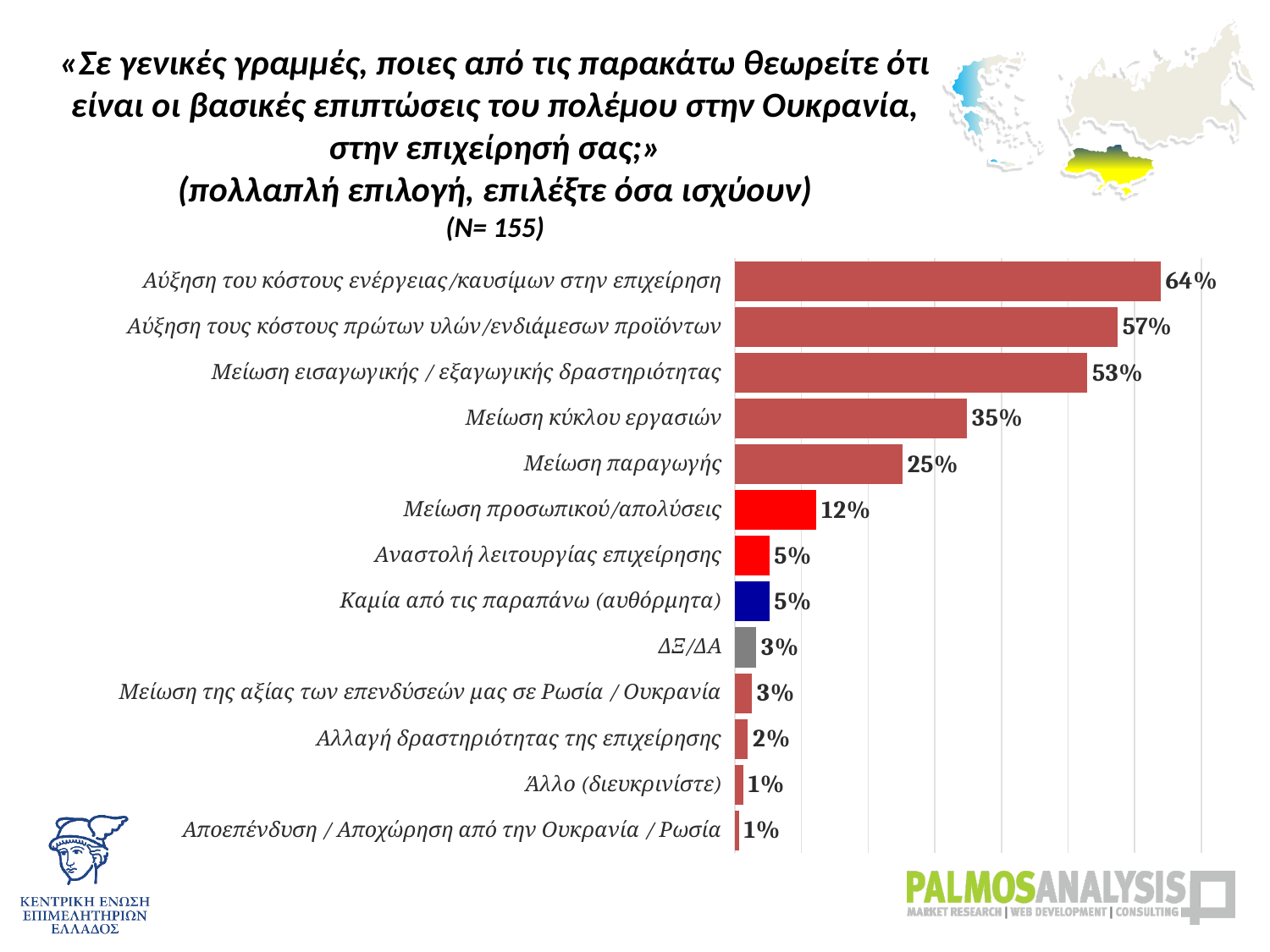
What type of chart is shown on the slide? Bar chart Which is larger: the value for «Μείωση εισαγωγικής / εξαγωγικής δραστηριότητας» or the value for «Μείωση κύκλου εργασιών»? Μείωση εισαγωγικής / εξαγωγικής δραστηριότητας What is the sample size (N) stated on the slide? 155 Which category has the highest percentage in the chart? Αύξηση του κόστους ενέργειας/καυσίμων στην επιχείρηση How many categories are shown in the chart? 13 What is the value for «ΔΞ/ΔΑ»? 3% What is the lowest percentage value shown in the chart? 1% What percentage is shown for «Μείωση προσωπικού/απολύσεις»? 12% What is the difference between «Μείωση κύκλου εργασιών» and «Μείωση παραγωγής»? 10% What is the difference between the values for «Αύξηση του κόστους ενέργειας/καυσίμων στην επιχείρηση» and «Αύξηση τους κόστους πρώτων υλών/ενδιάμεσων προϊόντων»? 7% What is the value shown for «Μείωση κύκλου εργασιών»? 35% What percentage of respondents selected «Αύξηση του κόστους ενέργειας/καυσίμων στην επιχείρηση»? 64%